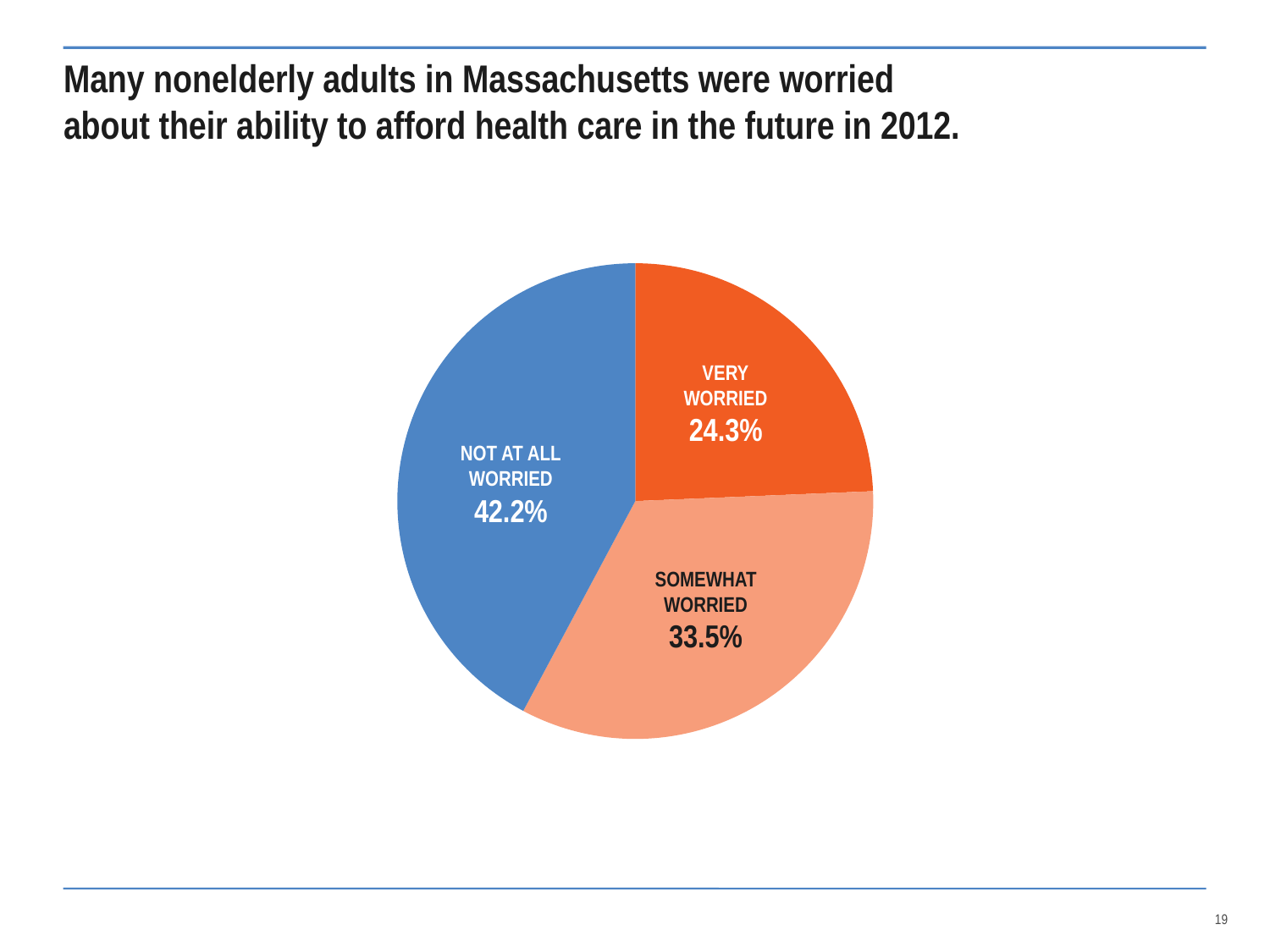
Which is larger, the share somewhat worried or the share very worried? Somewhat worried Which category has the largest share of the pie? Not at all worried What share of nonelderly adults were not at all worried? 42.2% What share of nonelderly adults were somewhat worried? 33.5% How many slices does the pie chart have? 3 What share of nonelderly adults were very worried? 24.3% Which category has the smallest share of the pie? Very worried What kind of chart is shown on the slide? pie chart Which colour is used for the not at all worried slice? Blue What is the combined share of adults who were very worried or somewhat worried? 57.8% What is the difference in percentage points between the somewhat worried and very worried shares? 9.2 What is the difference in percentage points between the not at all worried and very worried shares? 17.9